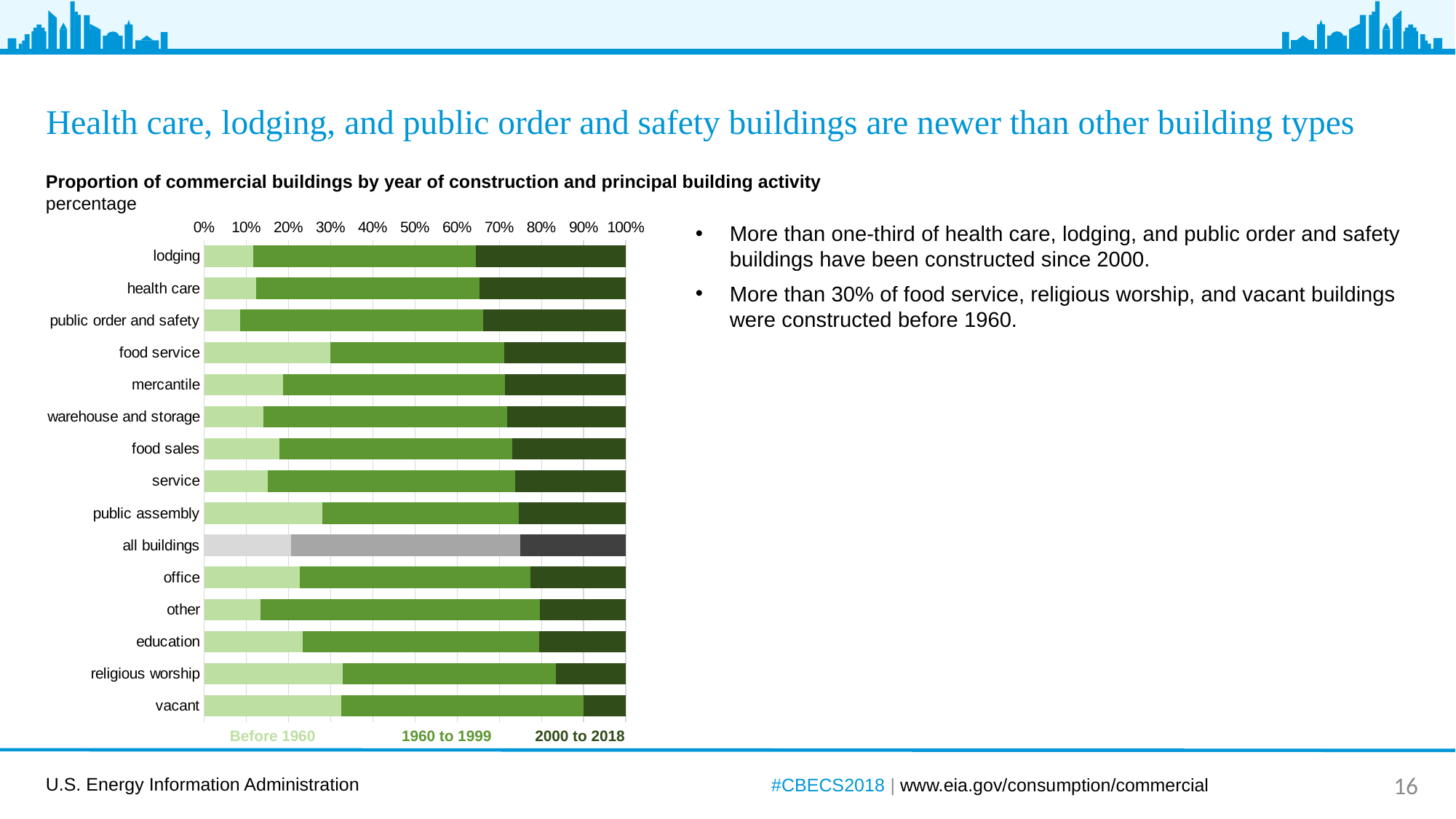
How many building categories are plotted on the chart? 15 What kind of chart is shown on the slide? stacked bar chart Which has the larger 2000 to 2018 share, lodging or vacant? lodging Is the 2000 to 2018 share for lodging greater or less than 30%? greater How many series does the chart's legend list? 3 What are the three series named in the legend? Before 1960, 1960 to 1999, 2000 to 2018 Is the Before 1960 share for public order and safety greater or less than 10%? less Is the 2000 to 2018 share for religious worship greater or less than 20%? less Which category's bar is drawn in gray rather than green? all buildings Which has the larger Before 1960 share, food service or mercantile? food service Which category has the smallest 2000 to 2018 share? vacant